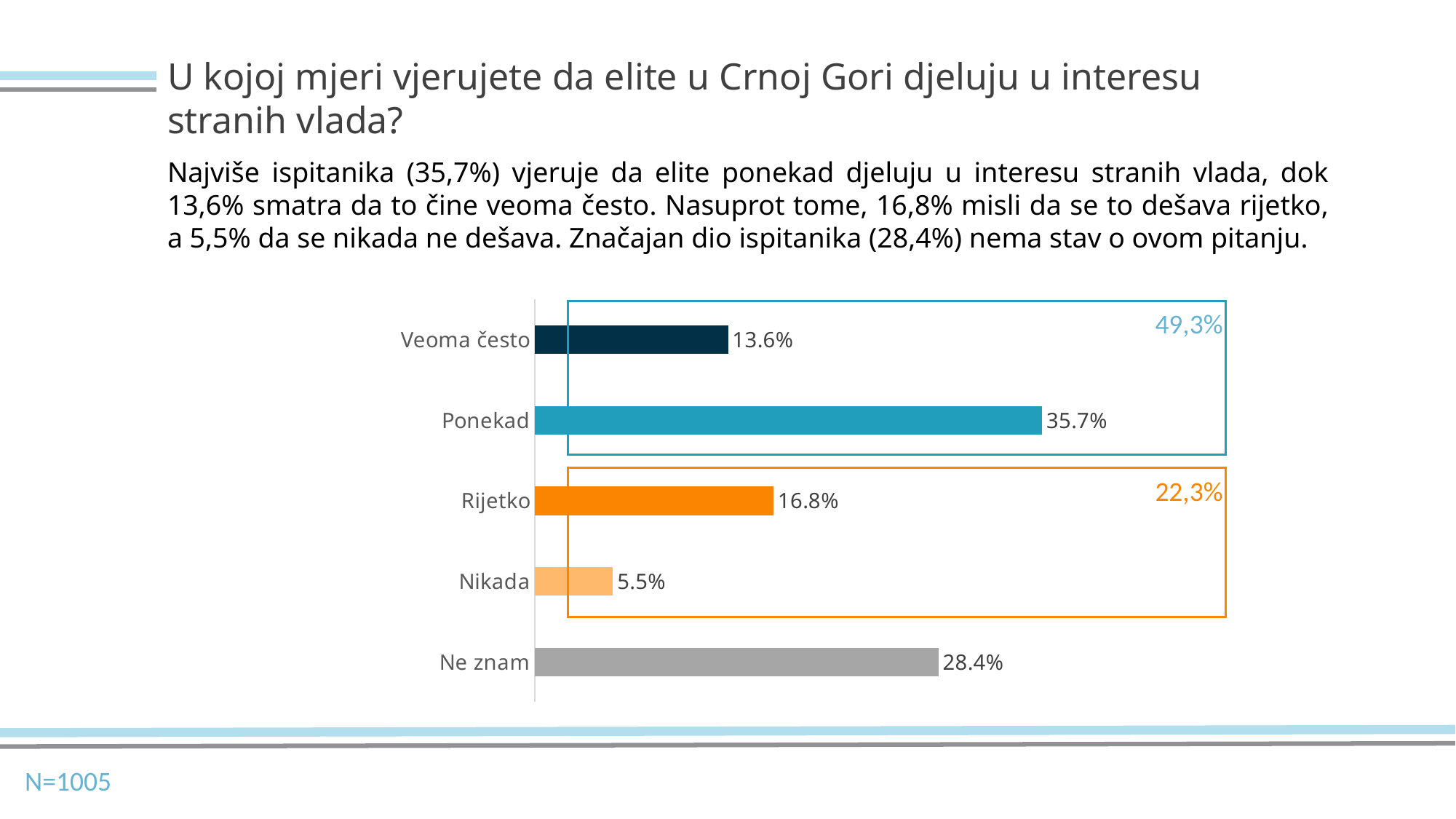
What kind of chart is shown on the slide? Bar chart Which category has the highest value? Ponekad What is the value for Nikada? 5.5% Which category has the lowest value? Nikada What is the value for Ponekad? 35.7% How many categories are shown in the chart? 5 What combined percentage is shown in the blue box grouping Veoma često and Ponekad? 49,3% Which is larger, the value for Rijetko or the value for Veoma često? Rijetko What is the difference between the values for Rijetko and Veoma često? 3.2% What is the value for Ne znam? 28.4% What is the value for Veoma često? 13.6% What is the difference between the values for Ponekad and Ne znam? 7.3%